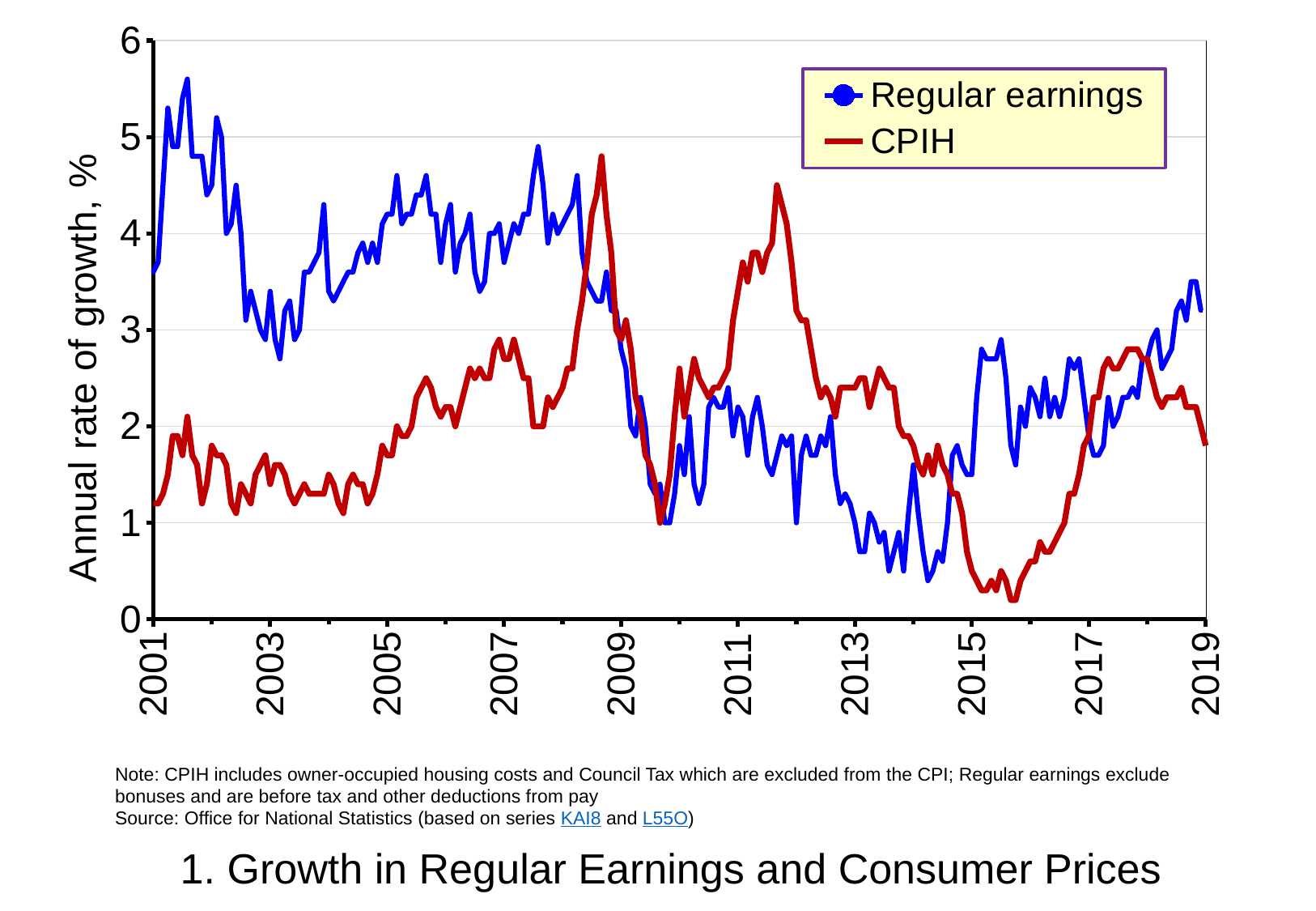
Does the CPIH series rise or fall between 2015 and 2017? rise What is the label on the vertical axis? Annual rate of growth, % At 2005, which series has the larger value, Regular earnings or CPIH? Regular earnings Is the value for CPIH at the start of 2001 greater or less than 2? less Is the highest value reached by CPIH (around late 2011) greater or less than 4? greater What kind of chart is shown on the slide? line chart What is the title of the chart? 1. Growth in Regular Earnings and Consumer Prices How many series does the legend list? 2 Which series reaches the highest value anywhere on the chart? Regular earnings Is the value for Regular earnings at the start of 2001 greater or less than 3? greater At 2011, which series has the larger value, Regular earnings or CPIH? CPIH